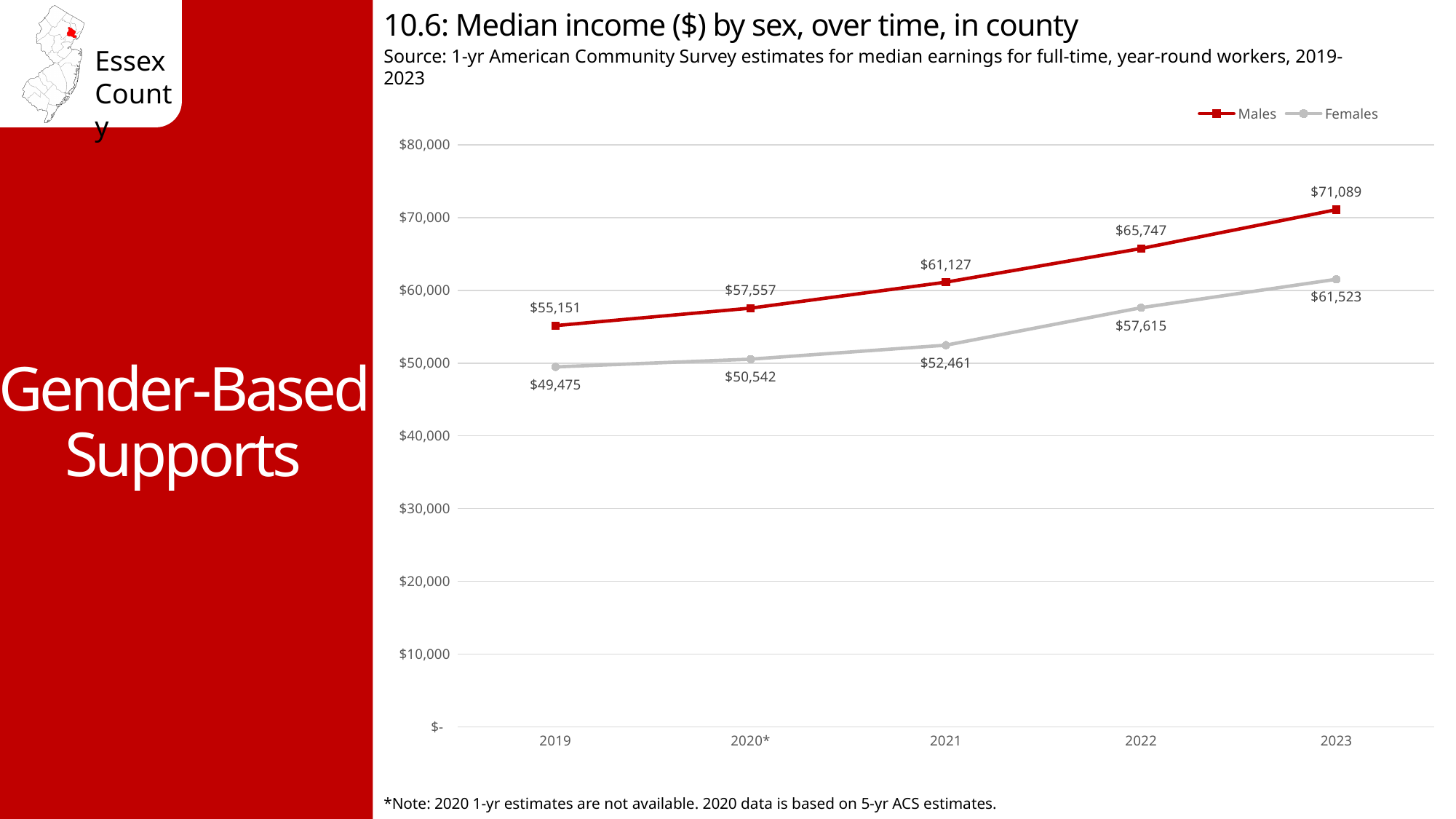
What is the difference between male and female median income in 2022? $8,132 What is the difference between male median income in 2023 and 2019? $15,938 Which was larger in 2021, the median income for males or for females? Males How many series does the legend list? 2 In which year was the median income for females highest? 2023 How many years are shown on the x axis? 5 In which year was the median income for males lowest? 2019 What was the median income for females in 2021? $52,461 What kind of chart is shown on the slide? Line chart What was the median income for males in 2023? $71,089 What was the median income for females in 2019? $49,475 What was the median income for males in 2020*? $57,557